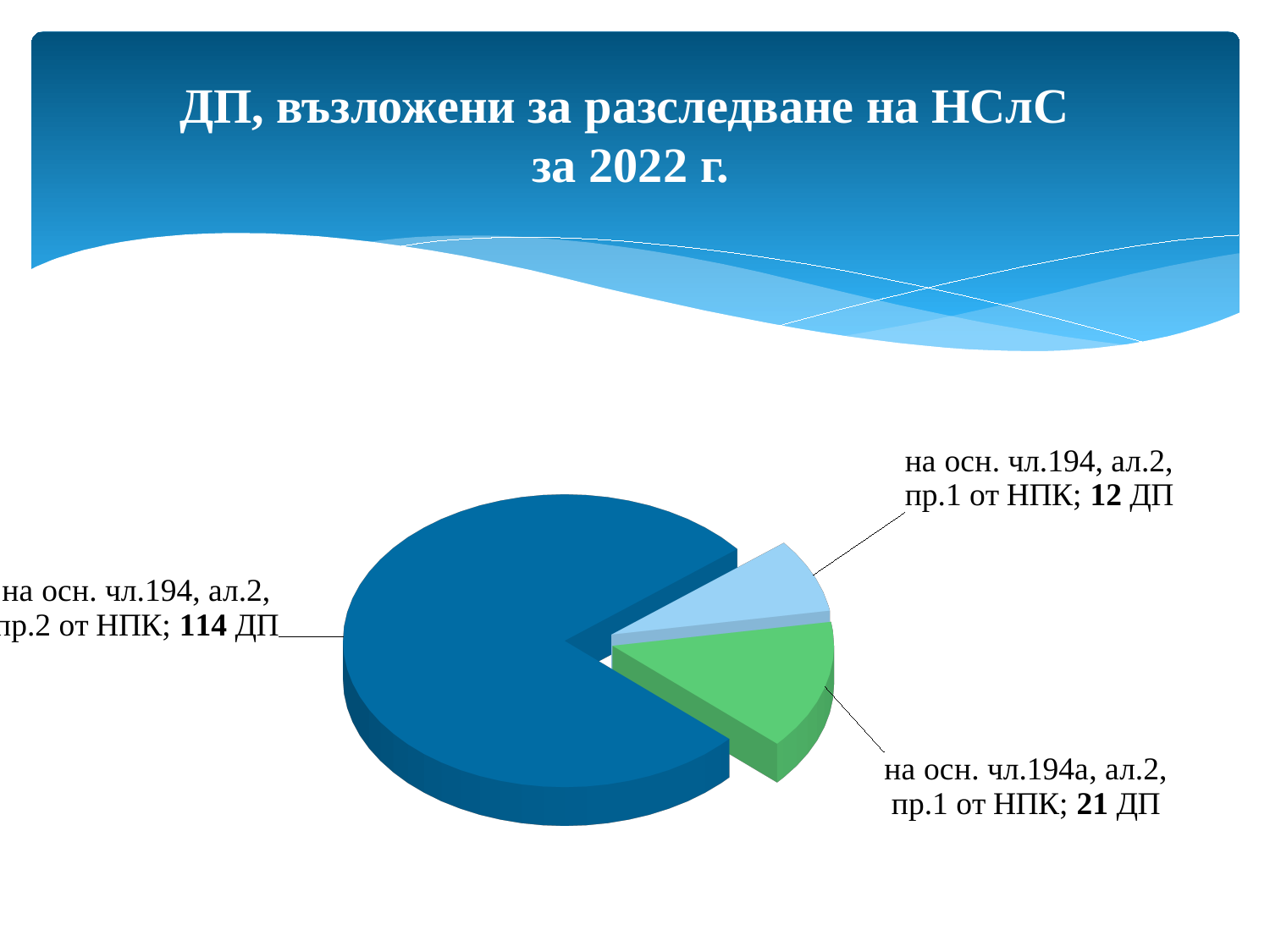
How many ДП were assigned на осн. чл.194а, ал.2, пр.1 от НПК? 21 ДП Which is larger: the number of ДП на осн. чл.194а, ал.2, пр.1 от НПК or на осн. чл.194, ал.2, пр.1 от НПК? на осн. чл.194а, ал.2, пр.1 от НПК Which category has the largest slice of the pie? на осн. чл.194, ал.2, пр.2 от НПК Which category has the smallest slice of the pie? на осн. чл.194, ал.2, пр.1 от НПК How many ДП were assigned на осн. чл.194, ал.2, пр.1 от НПК? 12 ДП What kind of chart is shown on the slide? pie chart What colour is the slice for на осн. чл.194а, ал.2, пр.1 от НПК? green What is the total number of ДП across all three slices of the pie? 147 ДП How many slices does the pie chart have? 3 What is the difference between the number of ДП на осн. чл.194, ал.2, пр.2 от НПК and на осн. чл.194а, ал.2, пр.1 от НПК? 93 ДП How many ДП were assigned на осн. чл.194, ал.2, пр.2 от НПК? 114 ДП What is the title of the chart on the slide? ДП, възложени за разследване на НСлС за 2022 г.